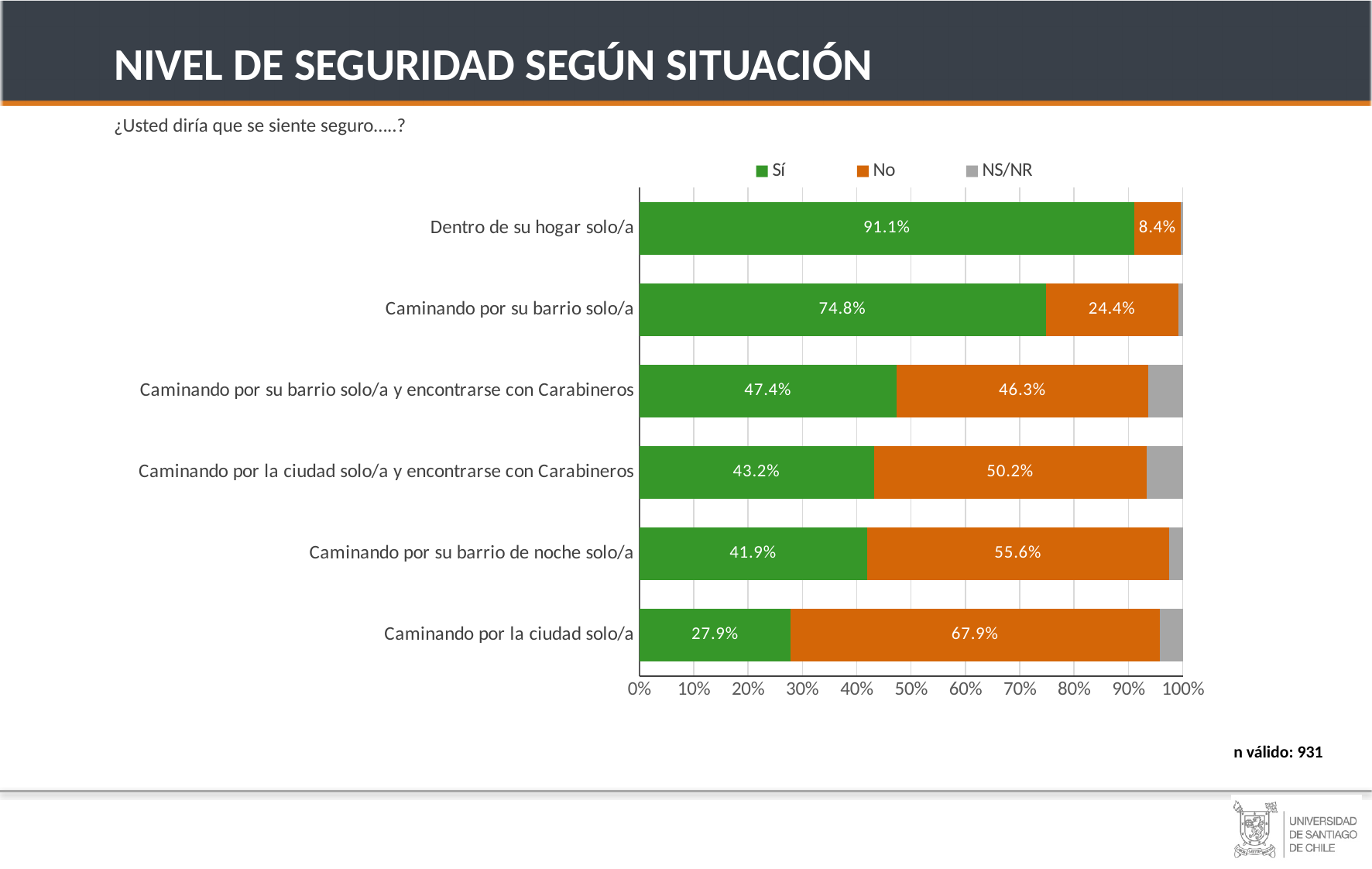
Which situation has the highest "No" percentage? Caminando por la ciudad solo/a What percentage answered "Sí" for "Dentro de su hogar solo/a"? 91.1% What is the difference between the "Sí" and "No" values for "Caminando por su barrio solo/a"? 50.4% Which situation has the highest "Sí" percentage? Dentro de su hogar solo/a Which situation has the lowest "Sí" percentage? Caminando por la ciudad solo/a What percentage answered "No" for "Caminando por la ciudad solo/a"? 67.9% What kind of chart is shown on the slide? Stacked bar chart How many series does the legend list? 3 How many situations (categories) are shown in the chart? 6 Which is larger: the "Sí" value for "Dentro de su hogar solo/a" or the "Sí" value for "Caminando por su barrio solo/a"? Dentro de su hogar solo/a Is the "Sí" value for "Caminando por la ciudad solo/a" greater or less than 30%? less What is the "No" value for "Caminando por su barrio de noche solo/a"? 55.6%